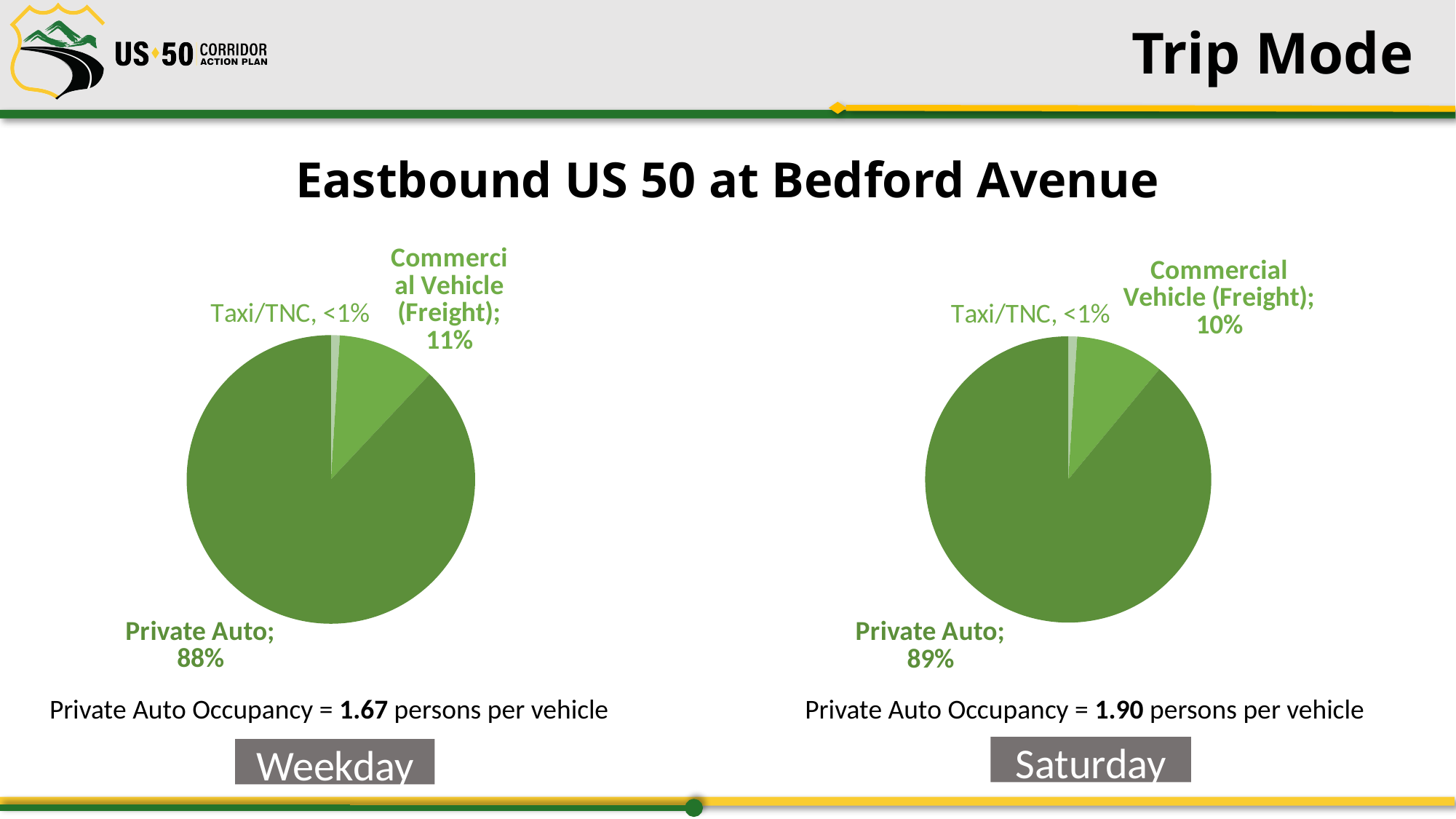
In the Saturday pie chart, what share is Private Auto? 89% What type of chart is used for the Saturday data? Pie chart What is the Private Auto Occupancy stated below the Saturday chart? 1.90 persons per vehicle How many categories does the Weekday pie chart show? 3 In the Weekday pie chart, what share is Commercial Vehicle (Freight)? 11% Is the Commercial Vehicle (Freight) share larger in the Weekday chart or the Saturday chart? Weekday In the Saturday pie chart, what share is Commercial Vehicle (Freight)? 10% In the Saturday pie chart, which category has the smallest share? Taxi/TNC What is the difference between the Private Auto share in the Saturday chart and the Private Auto share in the Weekday chart? 1% In the Weekday pie chart, what share is Taxi/TNC? <1% In the Weekday pie chart, what share is Private Auto? 88% In the Weekday pie chart, which category has the largest share? Private Auto